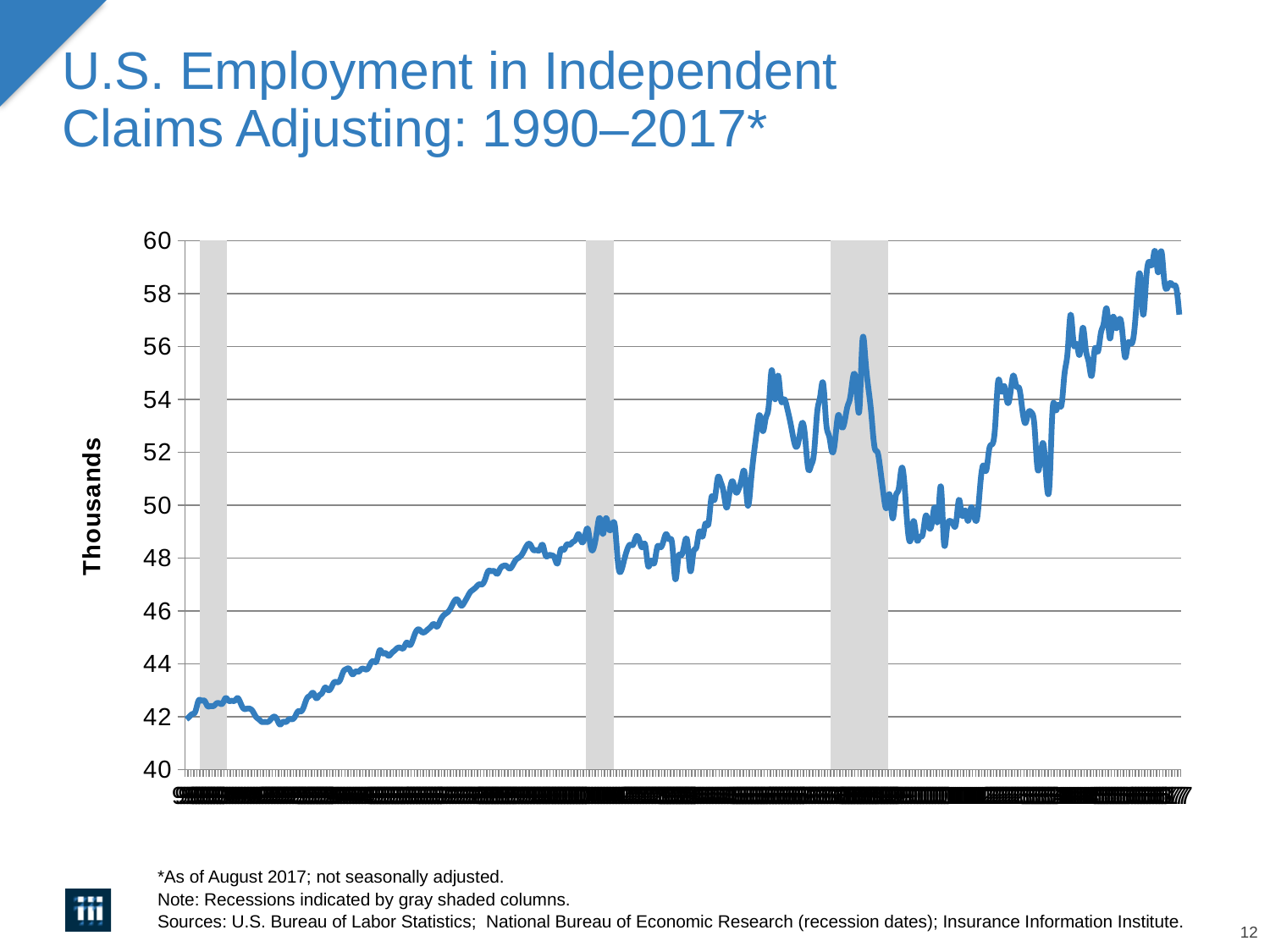
Does the line ever rise above the 60 gridline? No Is the lowest point reached by the line greater or less than 44? less How many gray shaded recession columns appear on the chart? 3 Is the value at the end of the series (right end of the line) greater or less than 56? greater Overall, do the values rise or fall from the left end of the x axis to the right end? rise What kind of chart is shown on the slide? line chart What is the label on the vertical axis? Thousands